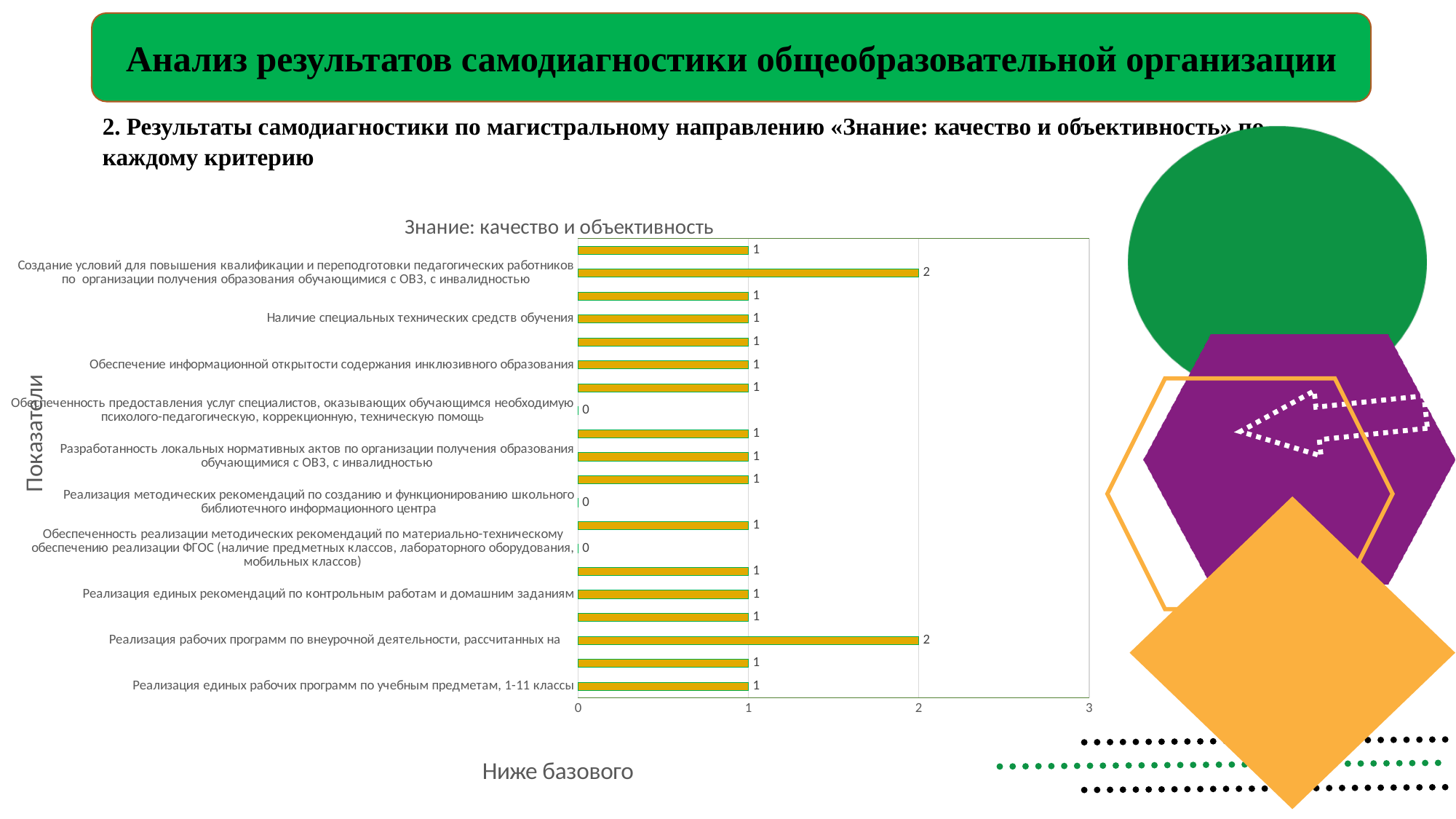
What kind of chart is shown on the slide? bar chart Which is larger: the value for "Реализация рабочих программ по внеурочной деятельности, рассчитанных на" or the value for "Реализация единых рекомендаций по контрольным работам и домашним заданиям"? Реализация рабочих программ по внеурочной деятельности, рассчитанных на What is the value for "Реализация рабочих программ по внеурочной деятельности, рассчитанных на"? 2 What is the value for "Наличие специальных технических средств обучения"? 1 What is the value for "Обеспеченность предоставления услуг специалистов, оказывающих обучающимся необходимую психолого-педагогическую, коррекционную, техническую помощь"? 0 What is the value for "Реализация методических рекомендаций по созданию и функционированию школьного библиотечного информационного центра"? 0 What is the title of the chart? Знание: качество и объективность What is the highest value shown by any bar in the chart? 2 What is the difference between the value for "Реализация рабочих программ по внеурочной деятельности, рассчитанных на" and the value for "Наличие специальных технических средств обучения"? 1 What is the value for "Реализация единых рабочих программ по учебным предметам, 1-11 классы"? 1 How many bars in the chart have a value of 2? 2 How many bars in the chart have a value of 0? 3